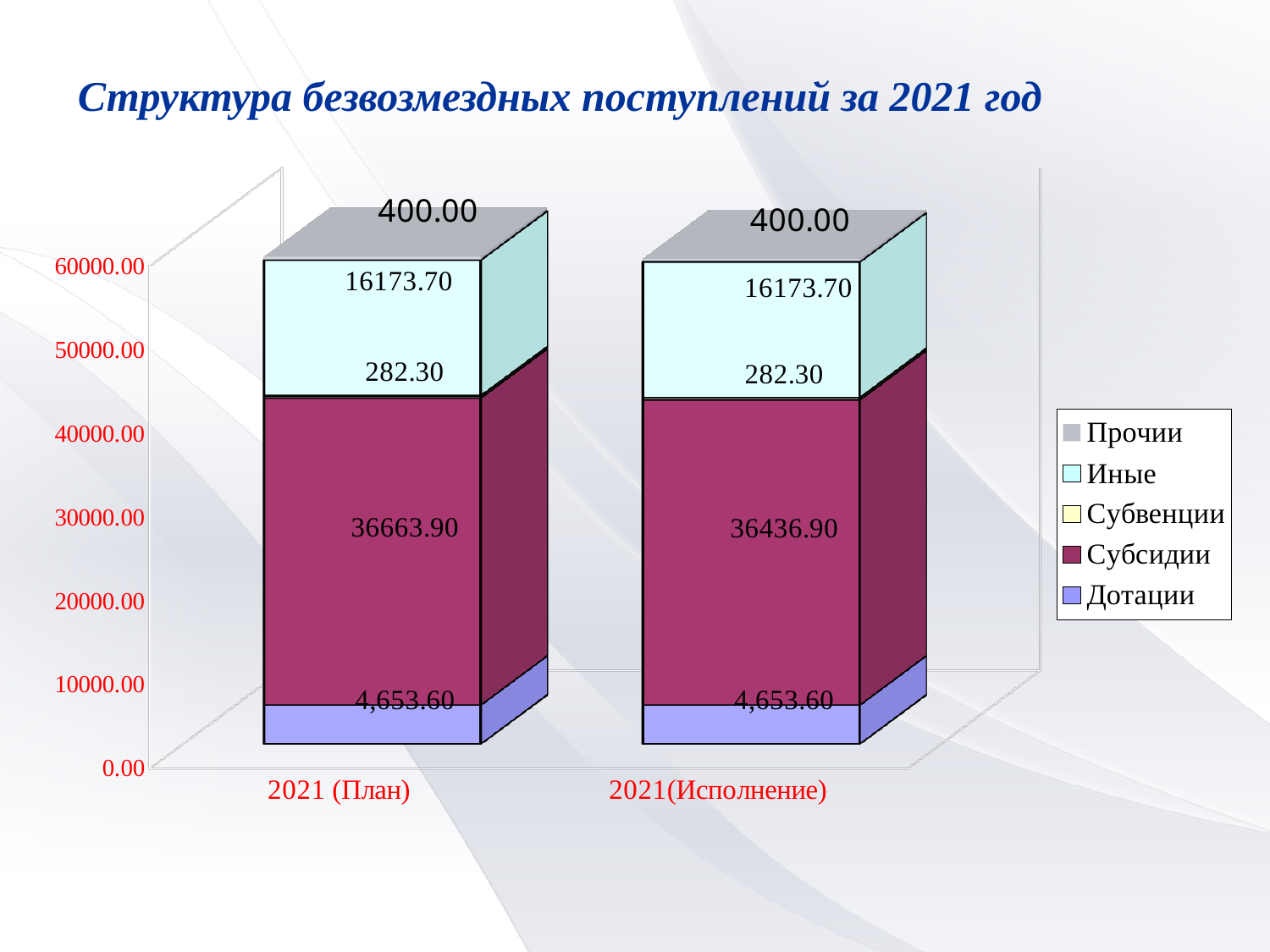
What is the value of Субсидии for 2021(Исполнение)? 36436.90 What is the value of Субсидии for 2021 (План)? 36663.90 What is the value of Субвенции for 2021(Исполнение)? 282.30 What is the difference between the Субсидии values for 2021 (План) and 2021(Исполнение)? 227.00 What is the value of Иные for 2021(Исполнение)? 16173.70 How many series does the legend list? 5 What is the value of Прочии for 2021 (План)? 400.00 Which series has the largest value in the 2021(Исполнение) bar? Субсидии Which is larger: Субсидии for 2021 (План) or Субсидии for 2021(Исполнение)? 2021 (План) What is the value of Дотации for 2021 (План)? 4,653.60 What kind of chart is shown on the slide? Stacked bar chart Which series has the smallest value in the 2021 (План) bar? Субвенции